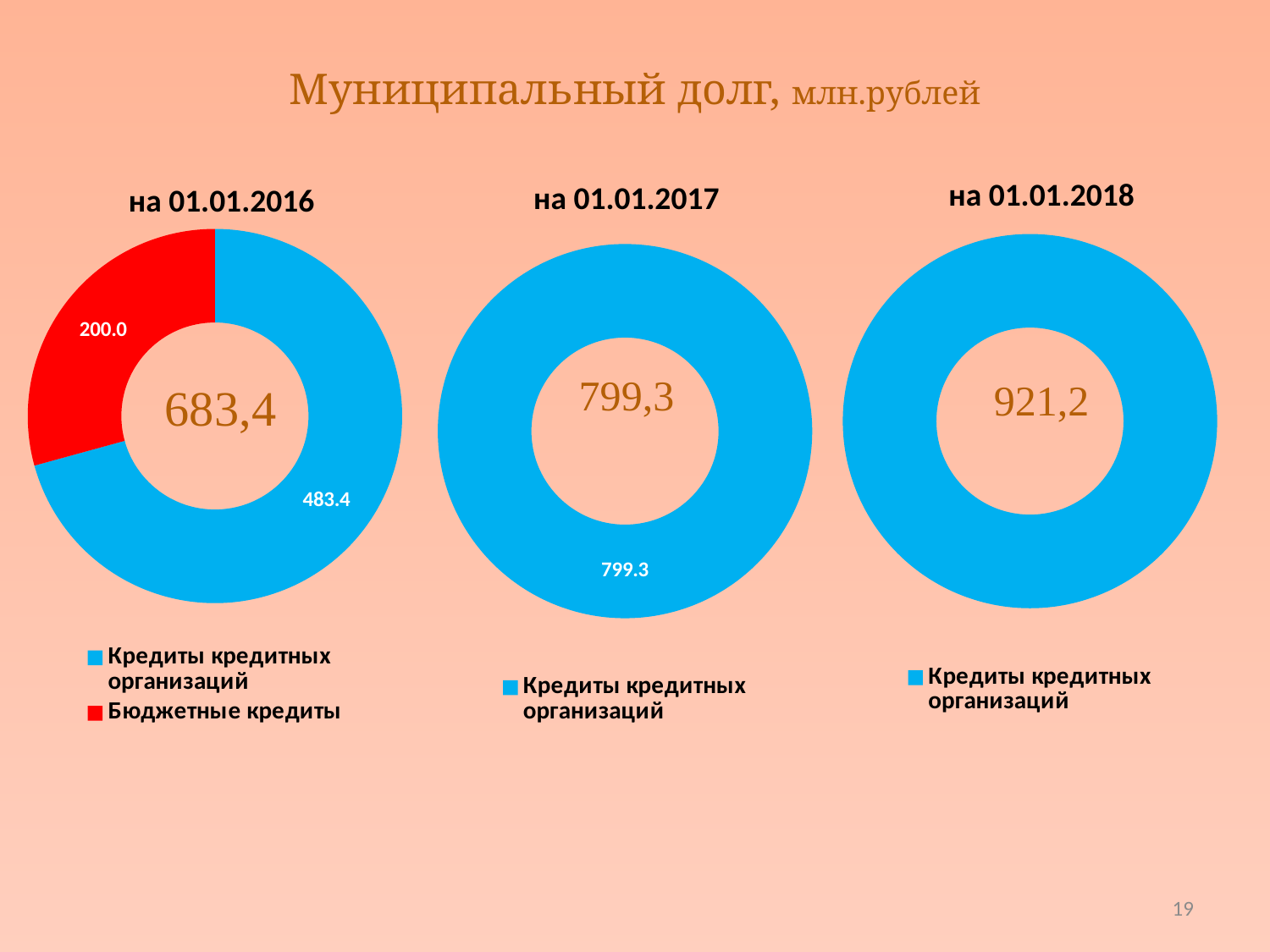
What kind of chart is the chart titled "на 01.01.2017"? Doughnut chart In the chart titled "на 01.01.2016", what is the difference between Кредиты кредитных организаций and Бюджетные кредиты? 283.4 In the chart titled "на 01.01.2016", what is the value for Кредиты кредитных организаций? 483.4 In the chart titled "на 01.01.2017", what is the value for Кредиты кредитных организаций? 799.3 How many categories does the legend of the chart titled "на 01.01.2016" list? 2 In the chart titled "на 01.01.2016", which category has the largest slice? Кредиты кредитных организаций In the chart titled "на 01.01.2016", which category has the smallest slice? Бюджетные кредиты What total is shown in the centre of the chart titled "на 01.01.2018"? 921,2 In the chart titled "на 01.01.2016", which is larger: Кредиты кредитных организаций or Бюджетные кредиты? Кредиты кредитных организаций What colour is the Бюджетные кредиты slice in the chart titled "на 01.01.2016"? Red How many categories does the legend of the chart titled "на 01.01.2018" list? 1 In the chart titled "на 01.01.2016", what is the value for Бюджетные кредиты? 200.0